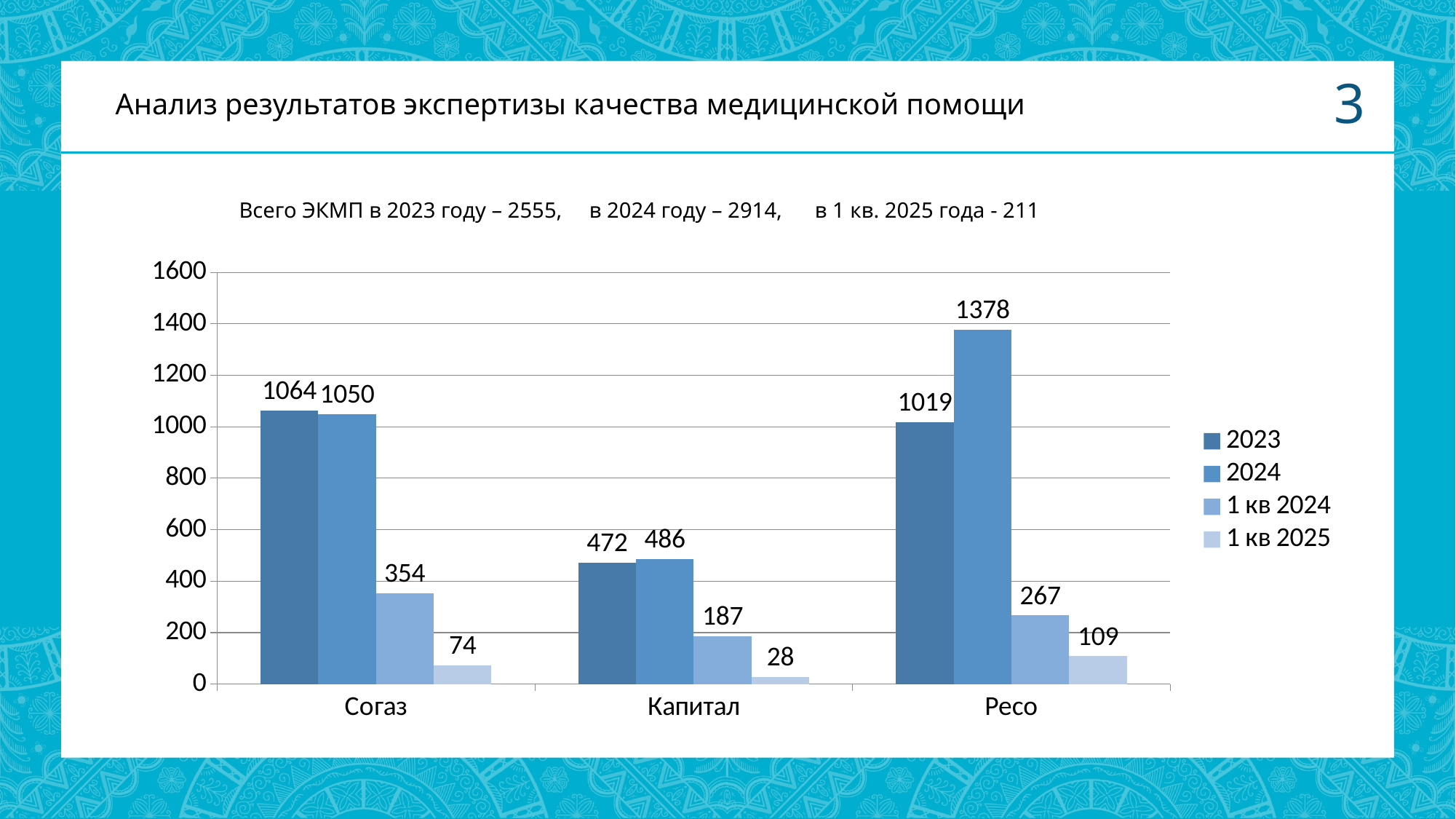
What is the value for Капитал in the 1 кв 2025 series? 28 What is the value for Ресо in the 2024 series? 1378 What kind of chart is shown on the slide? bar chart Which category has the highest value in the 2024 series? Ресо Which is larger for Капитал: the 2023 value or the 2024 value? 2024 What is the total number of ЭКМП in 2024 according to the text above the chart? 2914 Which category has the lowest value in the 1 кв 2024 series? Капитал How many series does the legend list? 4 What is the value for Согаз in the 2023 series? 1064 Is the value for Согаз in the 1 кв 2024 series greater or less than 400? less What is the difference between the 2024 and 2023 values for Ресо? 359 How many categories are shown on the x axis? 3